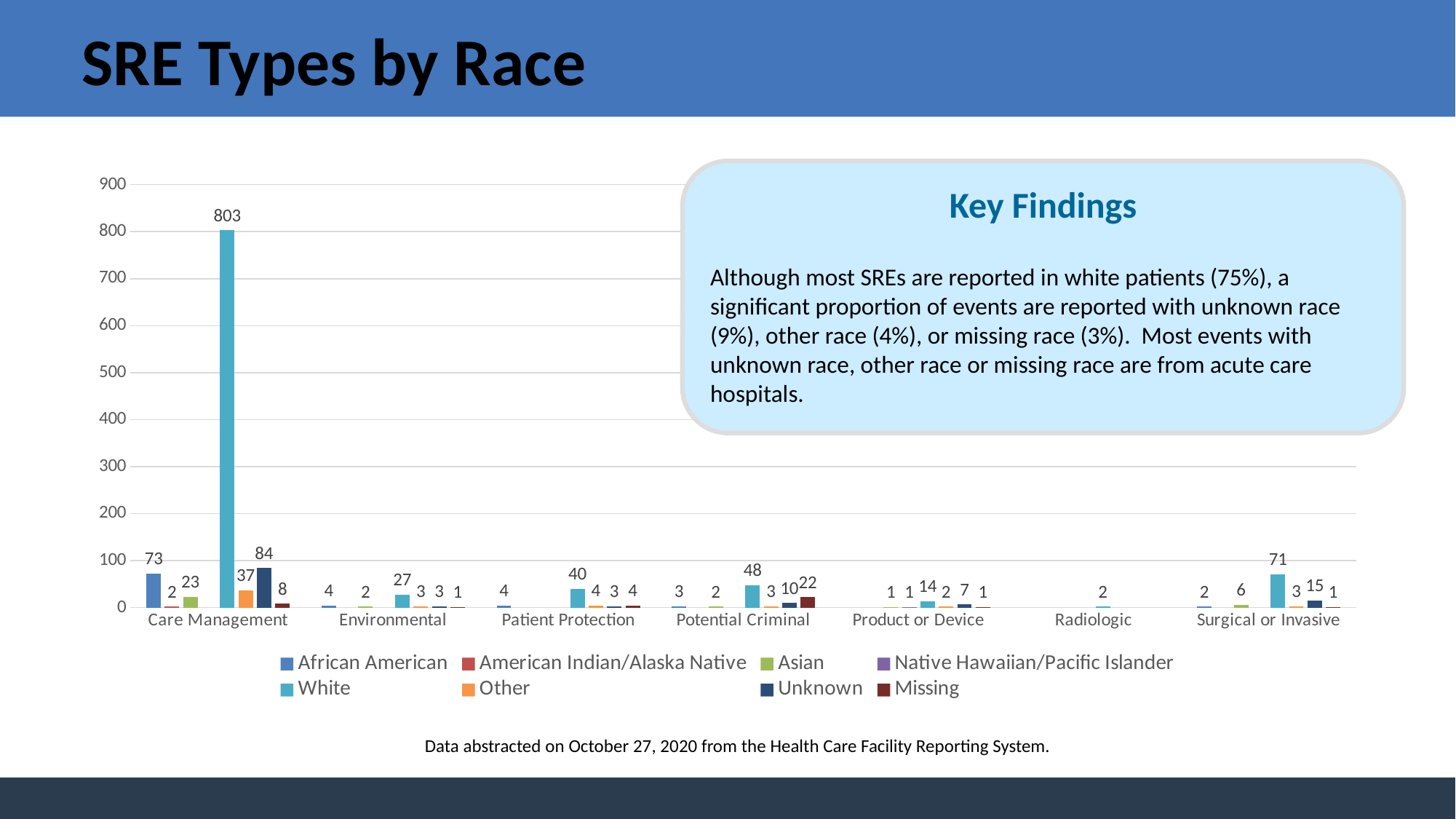
How many series does the legend list? 8 What is the value for White in the Surgical or Invasive category? 71 What is the title of the slide? SRE Types by Race What is the value for Unknown in the Care Management category? 84 Which category has the highest value for the White series? Care Management How many SRE type categories are shown on the x axis? 7 Which is larger: the White value for Potential Criminal or the White value for Patient Protection? Potential Criminal What kind of chart is shown on the slide? bar chart What is the difference between the White and Unknown values in the Care Management category? 719 What is the value for White in the Care Management category? 803 What is the value for Missing in the Potential Criminal category? 22 Is the value for White in Care Management greater or less than 500? greater